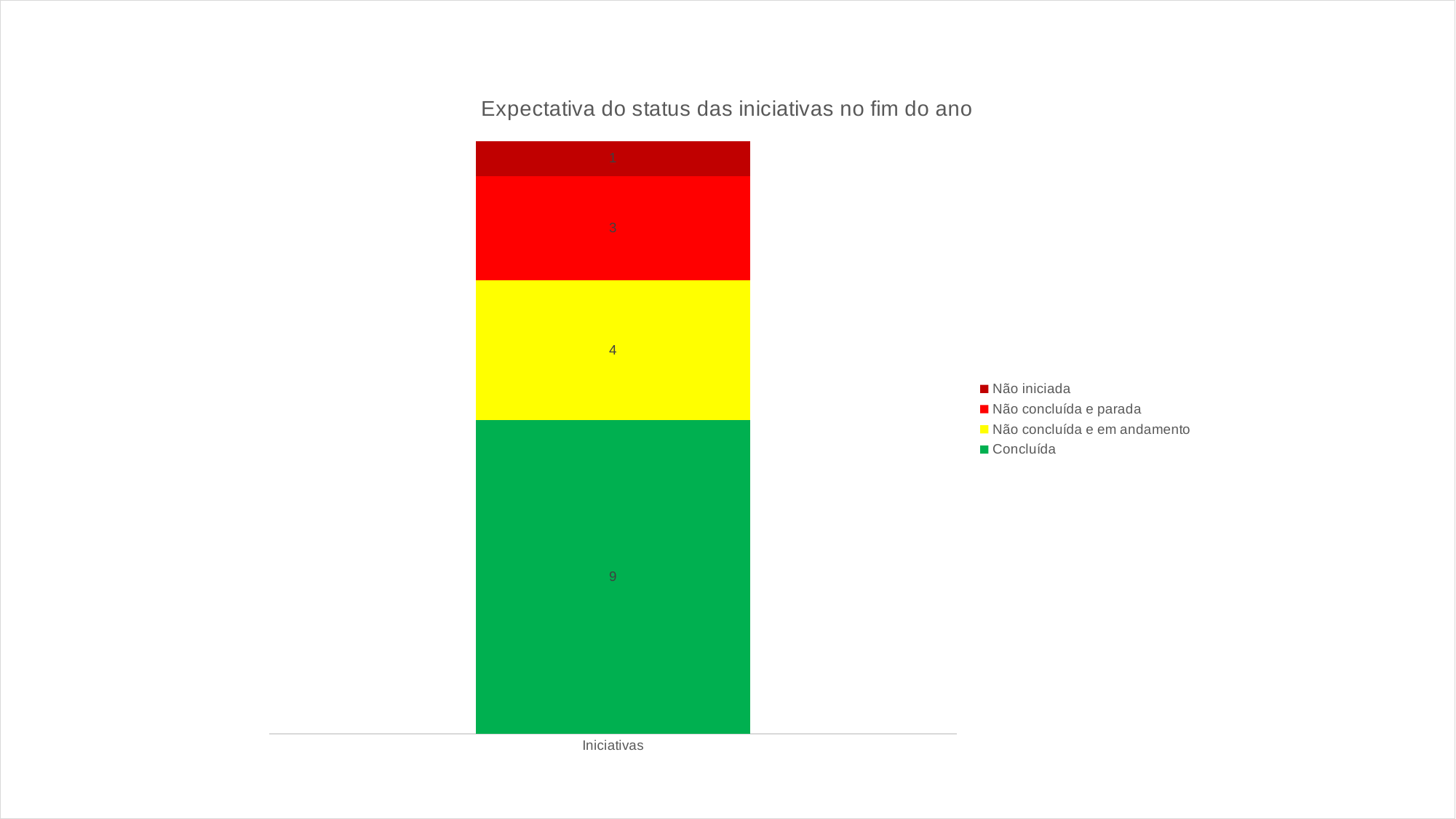
What is the total of the stacked Iniciativas bar? 17 What is the value for Não concluída e parada? 3 Which series has the highest value in the Iniciativas bar? Concluída What is the value for Concluída in the Iniciativas bar? 9 Which series has the lowest value in the Iniciativas bar? Não iniciada What is the difference between the Concluída value and the Não concluída e em andamento value? 5 What is the value for Não concluída e em andamento? 4 What is the title of the chart? Expectativa do status das iniciativas no fim do ano What kind of chart is shown on the slide? Stacked bar chart What is the value for Não iniciada? 1 How many series does the legend list? 4 Which is larger, the value for Não concluída e parada or the value for Não concluída e em andamento? Não concluída e em andamento